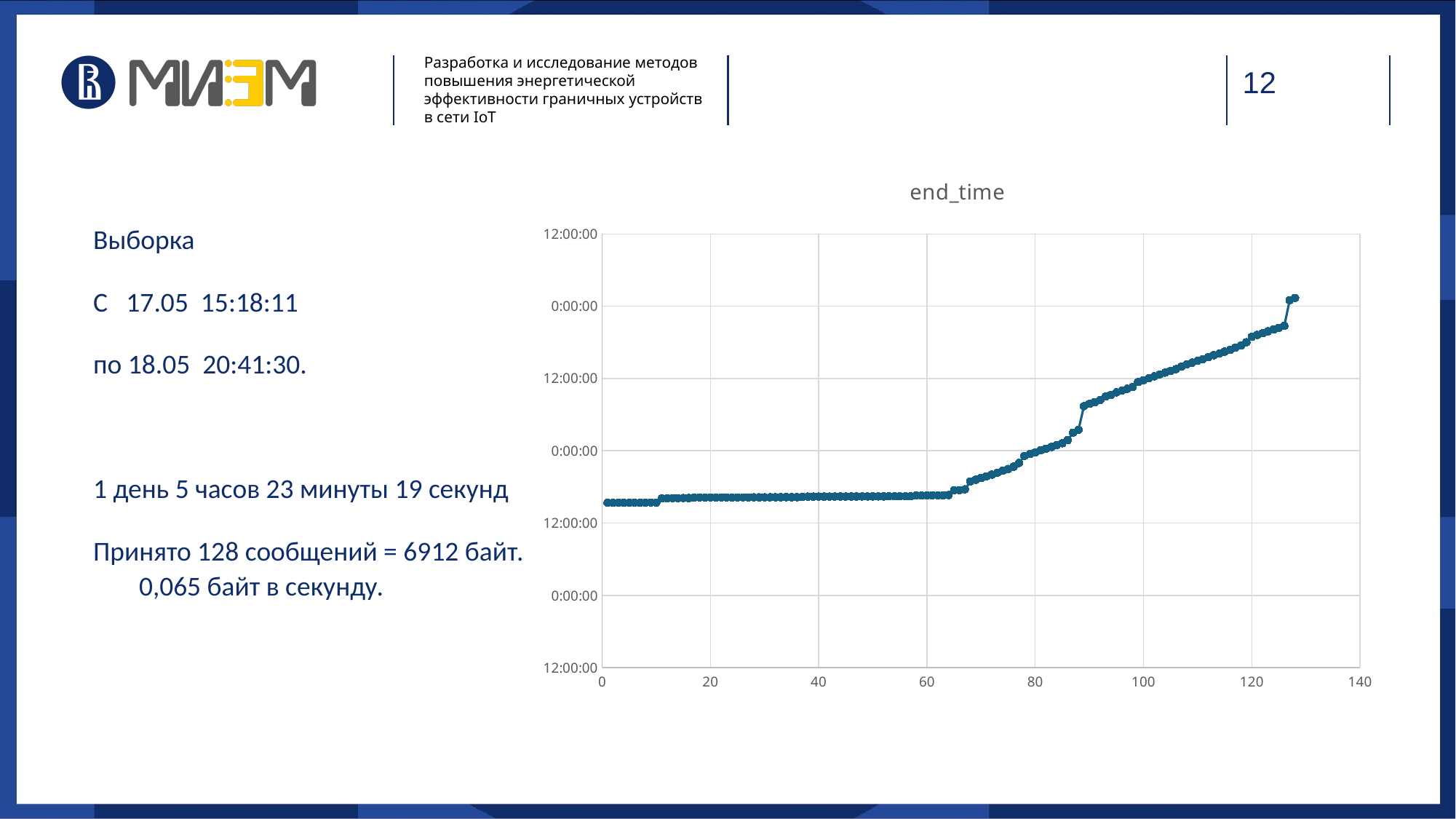
How many data series are plotted on the chart? 1 Between roughly x = 10 and x = 60, do the values rise steeply or stay nearly flat? stay nearly flat Do the plotted values rise or fall as the x axis increases? rise What is the title of the chart? end_time Which point is higher on the chart, the first point or the last point? the last point Is the x position of the last plotted point greater or less than 120? greater Is the x position of the last plotted point greater or less than 140? less What is the largest tick value shown on the x axis? 140 What kind of chart is shown on the slide? scatter chart Is the value at x = 40 higher or lower than the value at x = 100? lower